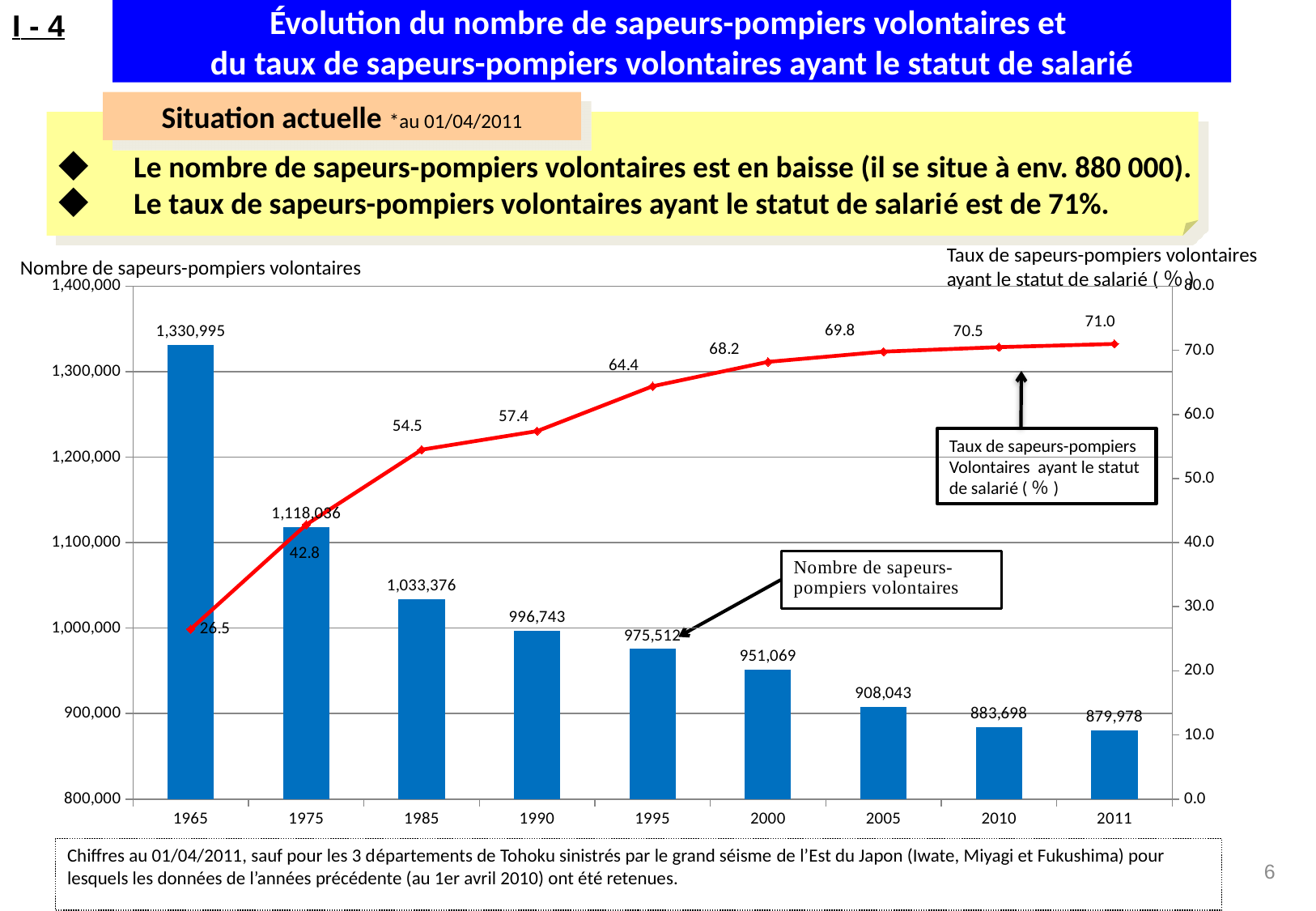
How does the rate of volunteer firefighters with salaried status change from 1965 to 2011? It rises What kind of chart is used to show the number of volunteer firefighters? Bar chart How many years are shown on the x axis of the chart? 9 What is the number of volunteer firefighters (sapeurs-pompiers volontaires) shown for 1965? 1,330,995 Is the number of volunteer firefighters in 2005 greater or less than 1,000,000? less Which is larger, the number of volunteer firefighters in 1985 or in 1990? 1985 What is the difference between the number of volunteer firefighters in 2010 and in 2011? 3,720 What is the rate of volunteer firefighters with salaried status (%) shown for 1995? 64.4 Which year has the highest number of volunteer firefighters? 1965 What is the number of volunteer firefighters shown for 2011? 879,978 What is the rate of volunteer firefighters with salaried status (%) shown for 1965? 26.5 Which year has the lowest rate of volunteer firefighters with salaried status? 1965